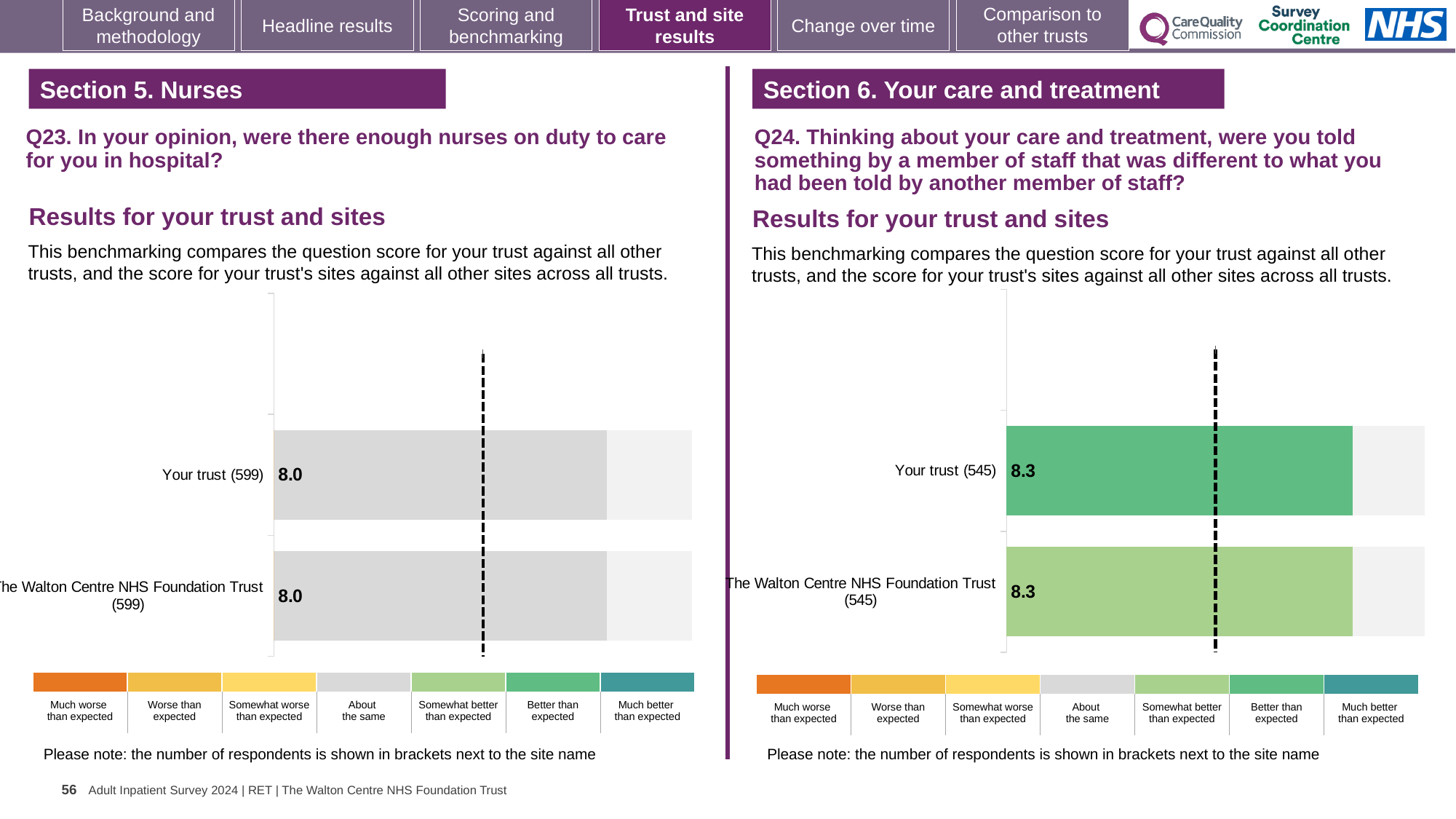
How many bars are plotted on the Q23 chart (left)? 2 On the Q23 chart (left), what is the score for Your trust (599)? 8.0 On the Q24 chart (right), what is the score for The Walton Centre NHS Foundation Trust (545)? 8.3 On the Q23 chart (left), what is the score for The Walton Centre NHS Foundation Trust (599)? 8.0 On the Q24 chart (right), what is the difference between the score for Your trust and the score for The Walton Centre NHS Foundation Trust? 0.0 On the Q24 chart (right), how many respondents are shown in brackets for The Walton Centre NHS Foundation Trust? 545 On the Q23 chart (left), how many respondents are shown in brackets for Your trust? 599 What kind of chart is used for the Q23 results on the left? Bar chart According to the colour key, which benchmark category does the grey colour of the bars on the Q23 chart (left) represent? About the same On the Q23 chart (left), what is the difference between the score for Your trust and the score for The Walton Centre NHS Foundation Trust? 0.0 How many bars are plotted on the Q24 chart (right)? 2 On the Q24 chart (right), what is the score for Your trust (545)? 8.3